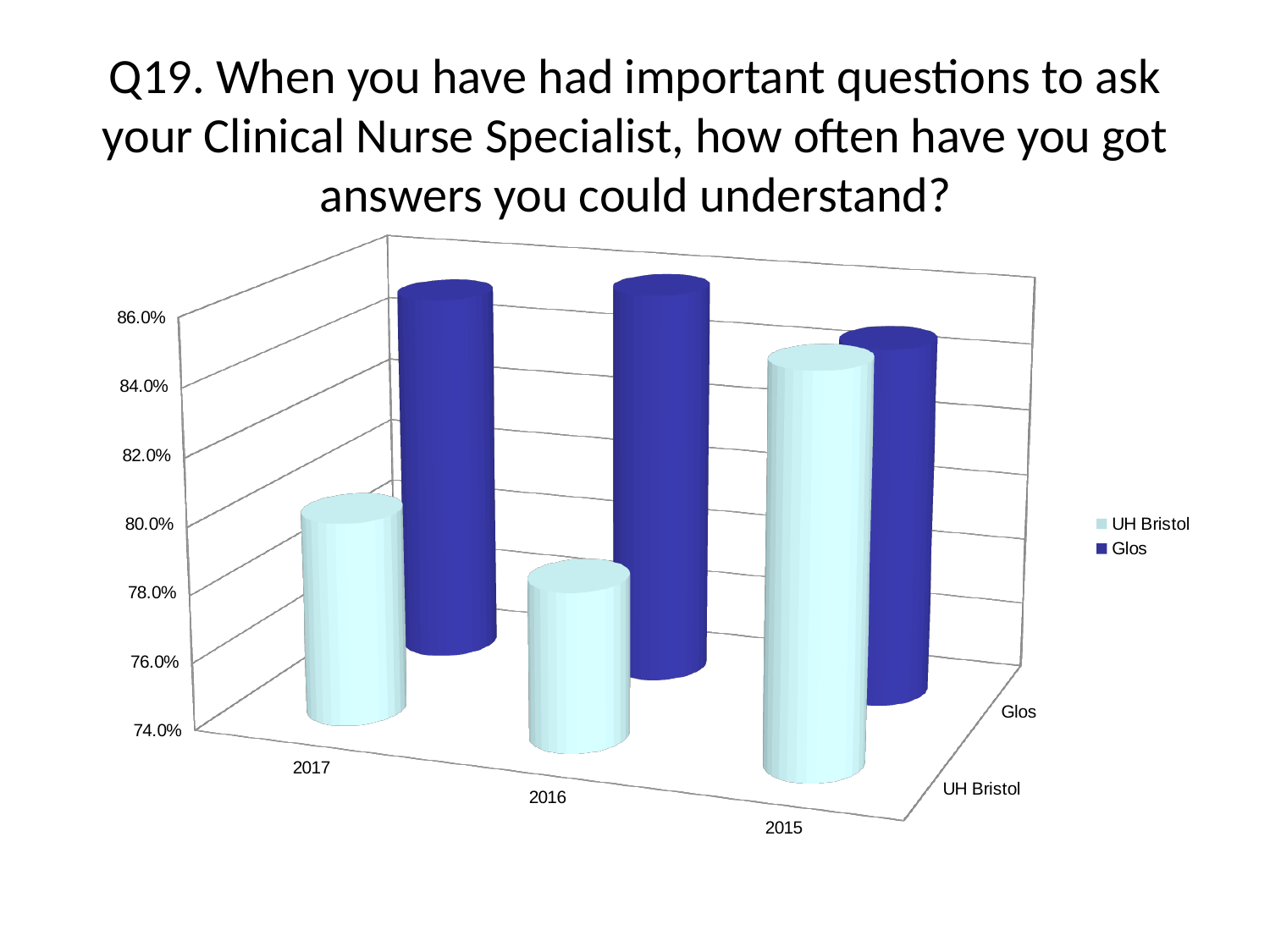
For UH Bristol, which year has the highest value? 2015 How many series does the legend list? 2 Which series is shown in dark blue? Glos Which two series are listed in the legend? UH Bristol and Glos In 2017, which is larger, UH Bristol or Glos? Glos Is the value for UH Bristol in 2016 greater or less than 82.0%? less Is the value for UH Bristol in 2015 greater or less than 82.0%? greater How many year categories are plotted on the x axis? 3 What kind of chart is shown on the slide? bar chart In 2016, which is larger, UH Bristol or Glos? Glos For UH Bristol, which year has the lowest value? 2016 Is the value for Glos in 2016 greater or less than 82.0%? greater